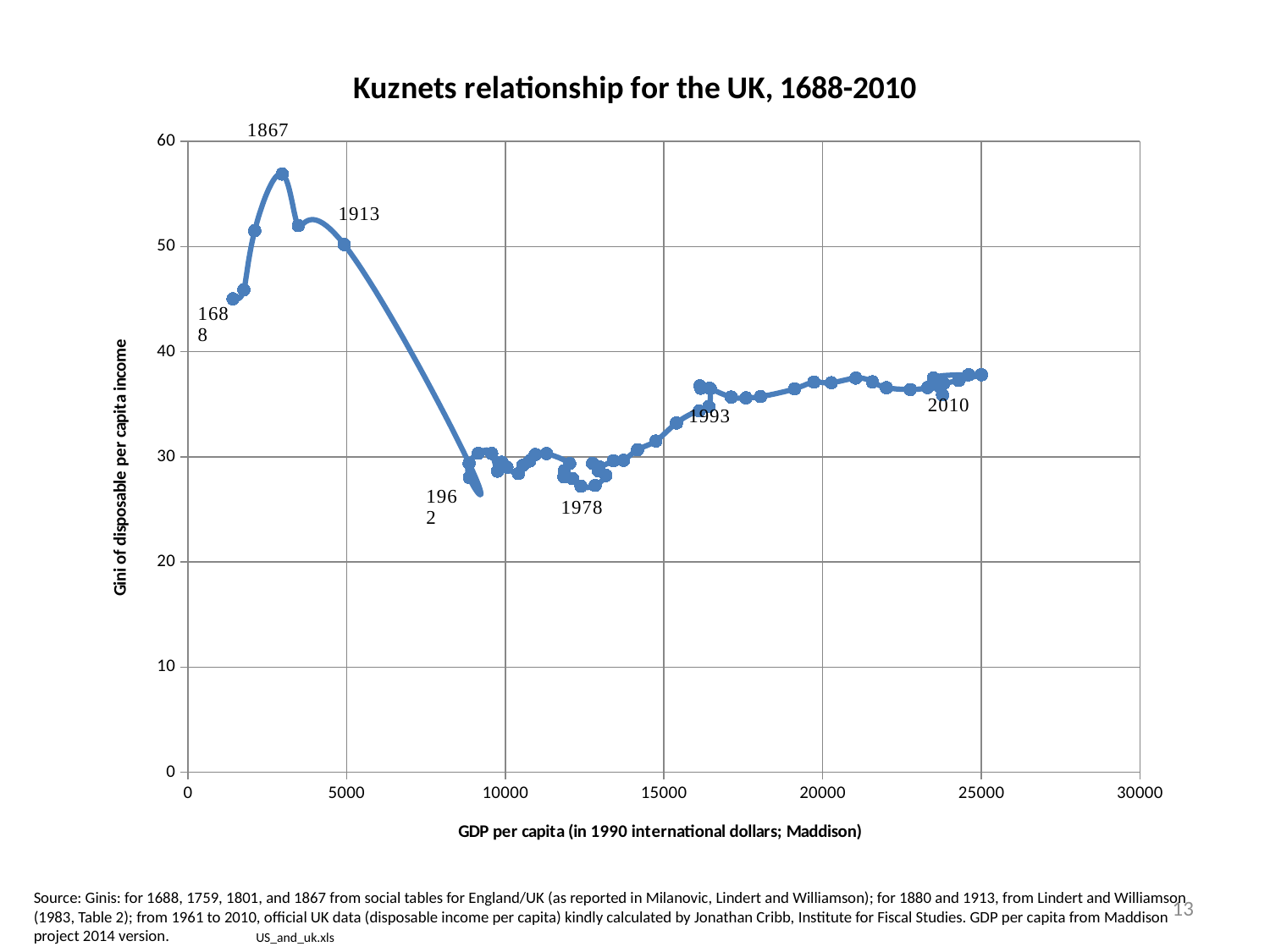
Which has the higher Gini value, the point labelled 1867 or the point labelled 1913? 1867 Is the Gini value for the point labelled 1688 greater or less than 50? less What kind of chart is shown on the slide? scatter chart Is the Gini value for the point labelled 2010 greater or less than 40? less Is the Gini value for the point labelled 1978 greater or less than 30? less What is the title of the chart? Kuznets relationship for the UK, 1688-2010 What is the label of the horizontal axis? GDP per capita (in 1990 international dollars; Maddison) Among the labelled years, which has the highest GDP per capita? 2010 Among the labelled years, which has the highest Gini value? 1867 Between the points labelled 1867 and 1962, does the Gini value rise or fall as GDP per capita increases? fall